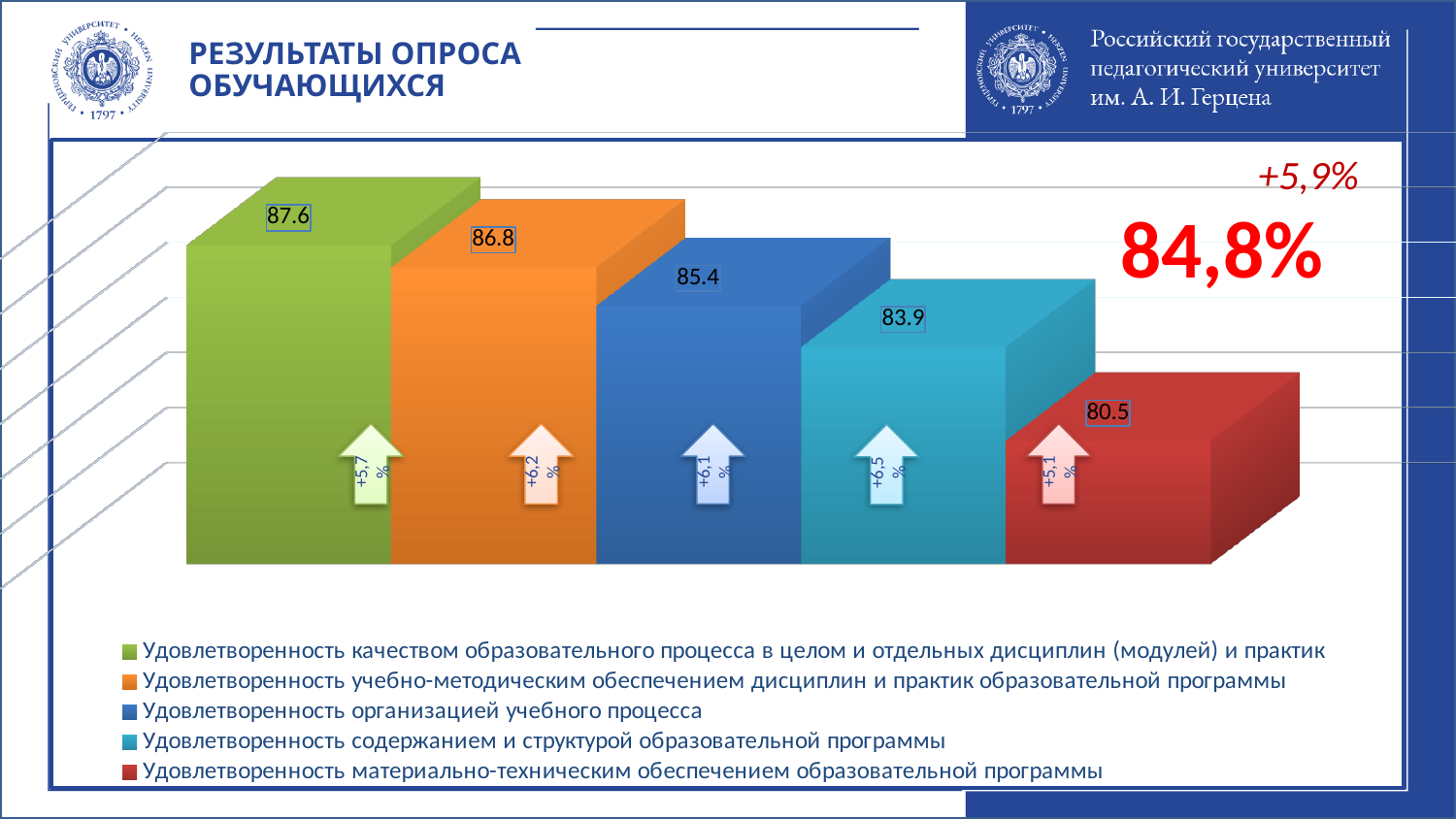
How many entries does the chart legend list? 5 What value is shown for "Удовлетворенность качеством образовательного процесса в целом и отдельных дисциплин (модулей) и практик"? 87.6 What value is shown for "Удовлетворенность содержанием и структурой образовательной программы"? 83.9 What is the difference between the highest value (87.6) and the lowest value (80.5) in the chart? 7.1 What value is shown for "Удовлетворенность организацией учебного процесса"? 85.4 Which is larger: the value for "Удовлетворенность организацией учебного процесса" or the value for "Удовлетворенность содержанием и структурой образовательной программы"? Удовлетворенность организацией учебного процесса Which legend entry has the lowest value in the chart? Удовлетворенность материально-техническим обеспечением образовательной программы Which legend entry has the highest value in the chart? Удовлетворенность качеством образовательного процесса в целом и отдельных дисциплин (модулей) и практик What value is shown for "Удовлетворенность материально-техническим обеспечением образовательной программы"? 80.5 What value is shown for "Удовлетворенность учебно-методическим обеспечением дисциплин и практик образовательной программы"? 86.8 What kind of chart is shown on the slide? Bar chart How many bars are plotted in the chart? 5